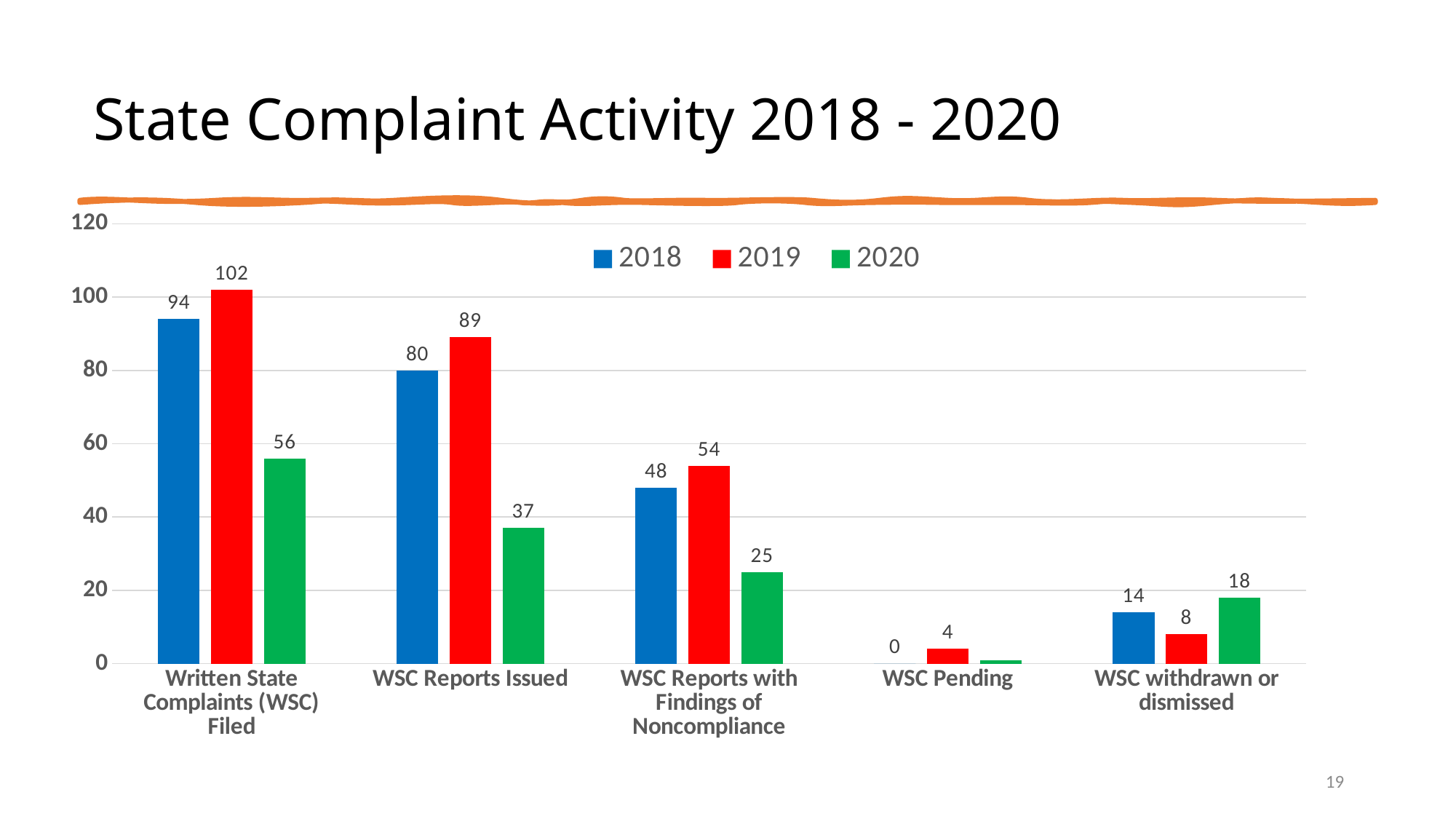
What was the 2018 value for WSC Reports with Findings of Noncompliance? 48 How many series does the legend list? 3 What was the value for Written State Complaints (WSC) Filed in 2019? 102 Which year had the highest number of Written State Complaints (WSC) Filed? 2019 Which year had the lowest value for WSC withdrawn or dismissed? 2019 How many WSC Reports Issued were there in 2020? 37 What colour represents the 2020 series? Green What was the value for WSC withdrawn or dismissed in 2019? 8 Which is larger: the 2018 value for WSC withdrawn or dismissed or the 2020 value? 2020 How many categories are shown on the x axis? 5 What is the difference between the 2019 and 2020 values for WSC Reports Issued? 52 What kind of chart is shown on the slide? Bar chart